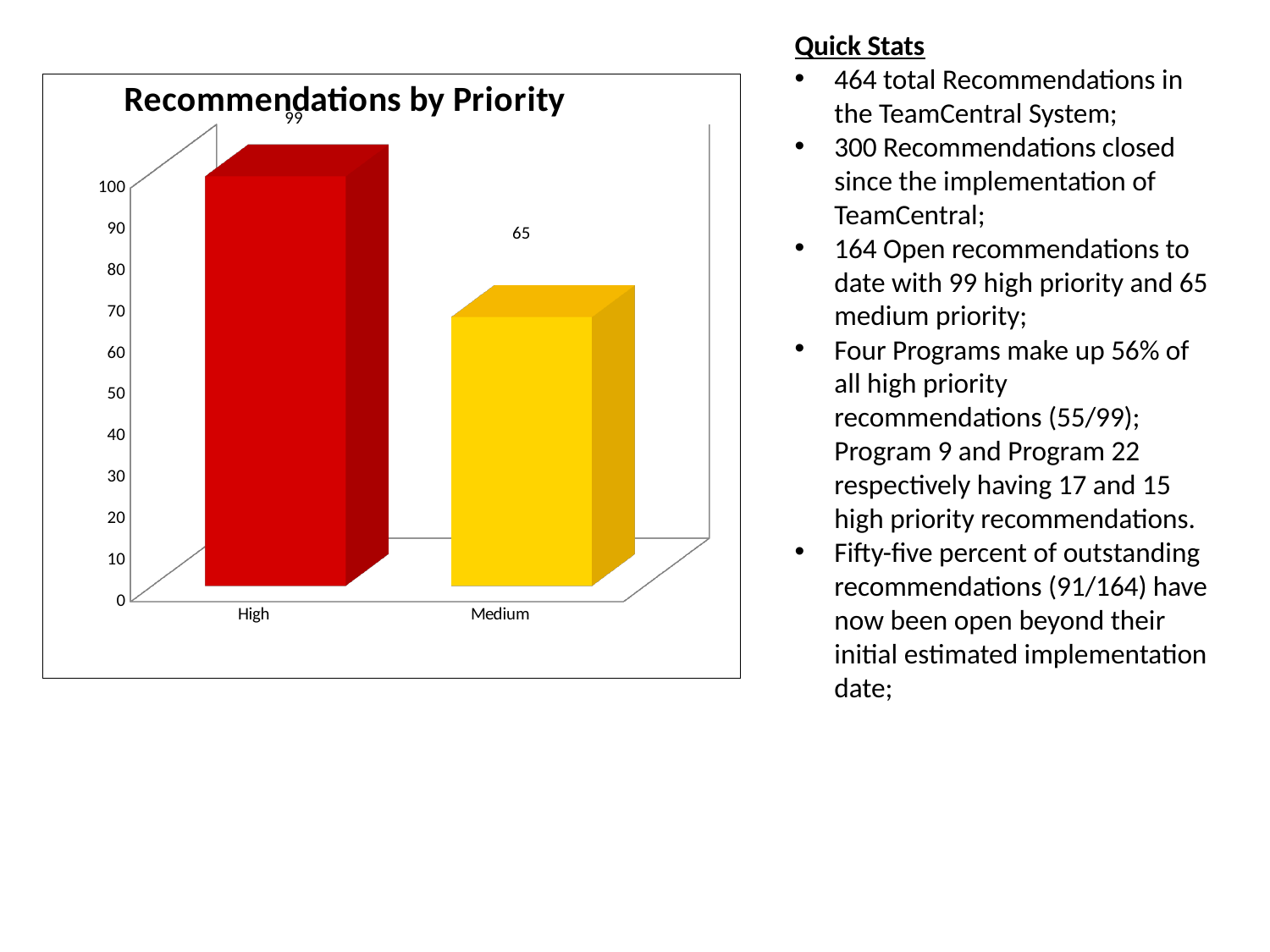
What is the value for Medium in the Recommendations by Priority chart? 65 What is the title of the chart? Recommendations by Priority What kind of chart is shown on the slide? bar chart What is the difference between the High and Medium values? 34 Which is larger, the value for High or the value for Medium? High Which priority category has the lowest value? Medium How many categories are shown on the x axis of the chart? 2 What is the value for High in the Recommendations by Priority chart? 99 Is the value for High greater or less than 90? greater Is the value for Medium greater or less than 70? less Which priority category has the highest value? High What colour is the bar for High? red